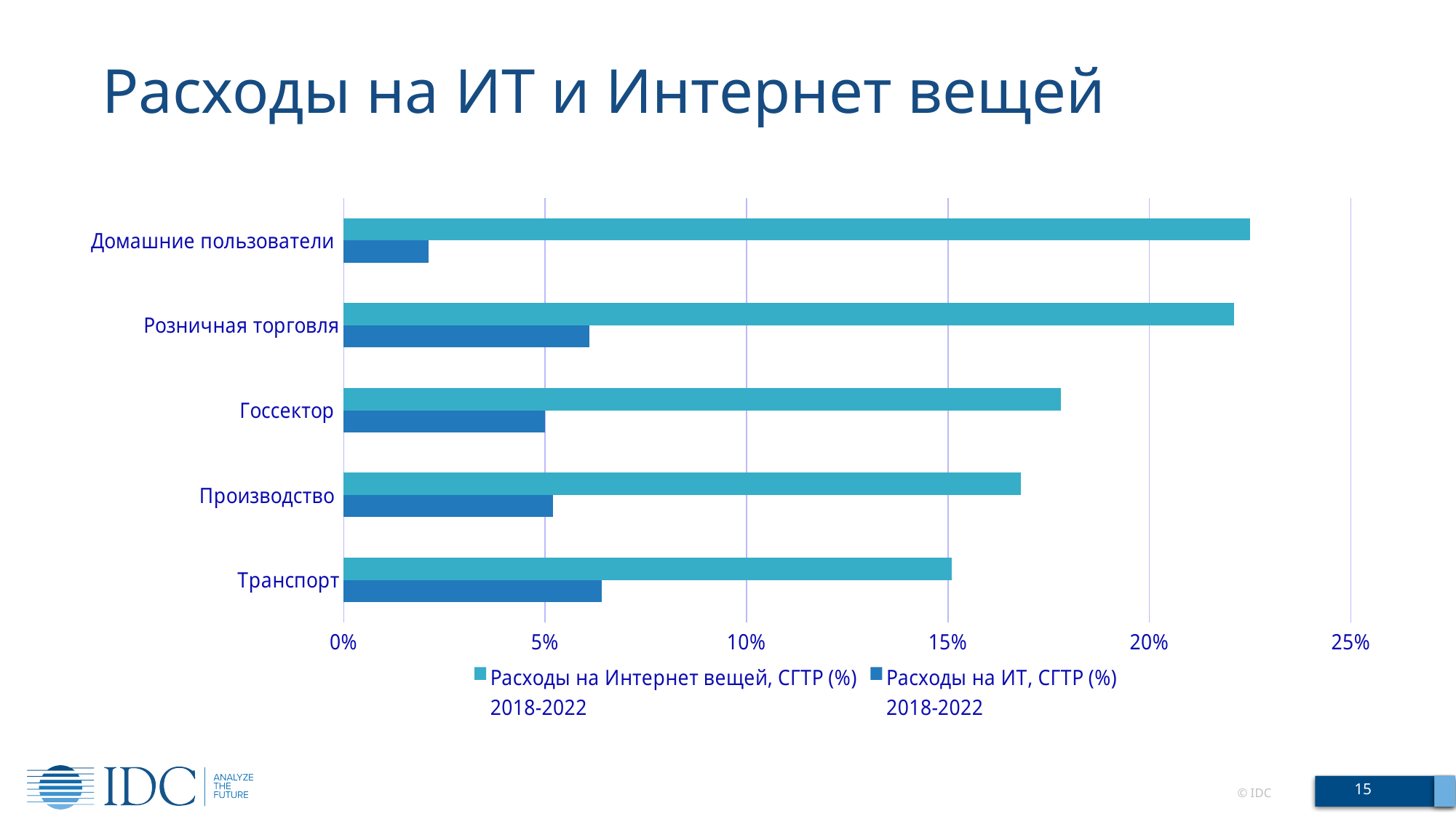
Is the value for Розничная торговля in the Расходы на ИТ series greater or less than 5%? greater Which is larger for Расходы на Интернет вещей: Госсектор or Производство? Госсектор How many series does the legend list? 2 Is the value for Производство in the Расходы на Интернет вещей series greater or less than 20%? less Is the value for Домашние пользователи in the Расходы на Интернет вещей series greater or less than 20%? greater Which category has the lowest value for Расходы на ИТ, CGTR (%) 2018-2022? Домашние пользователи Which is larger for Расходы на ИТ: Розничная торговля or Домашние пользователи? Розничная торговля What is the title of the slide? Расходы на ИТ и Интернет вещей Which category has the lowest value for Расходы на Интернет вещей, CGTR (%) 2018-2022? Транспорт How many categories are shown on the chart? 5 What kind of chart is shown on the slide? bar chart